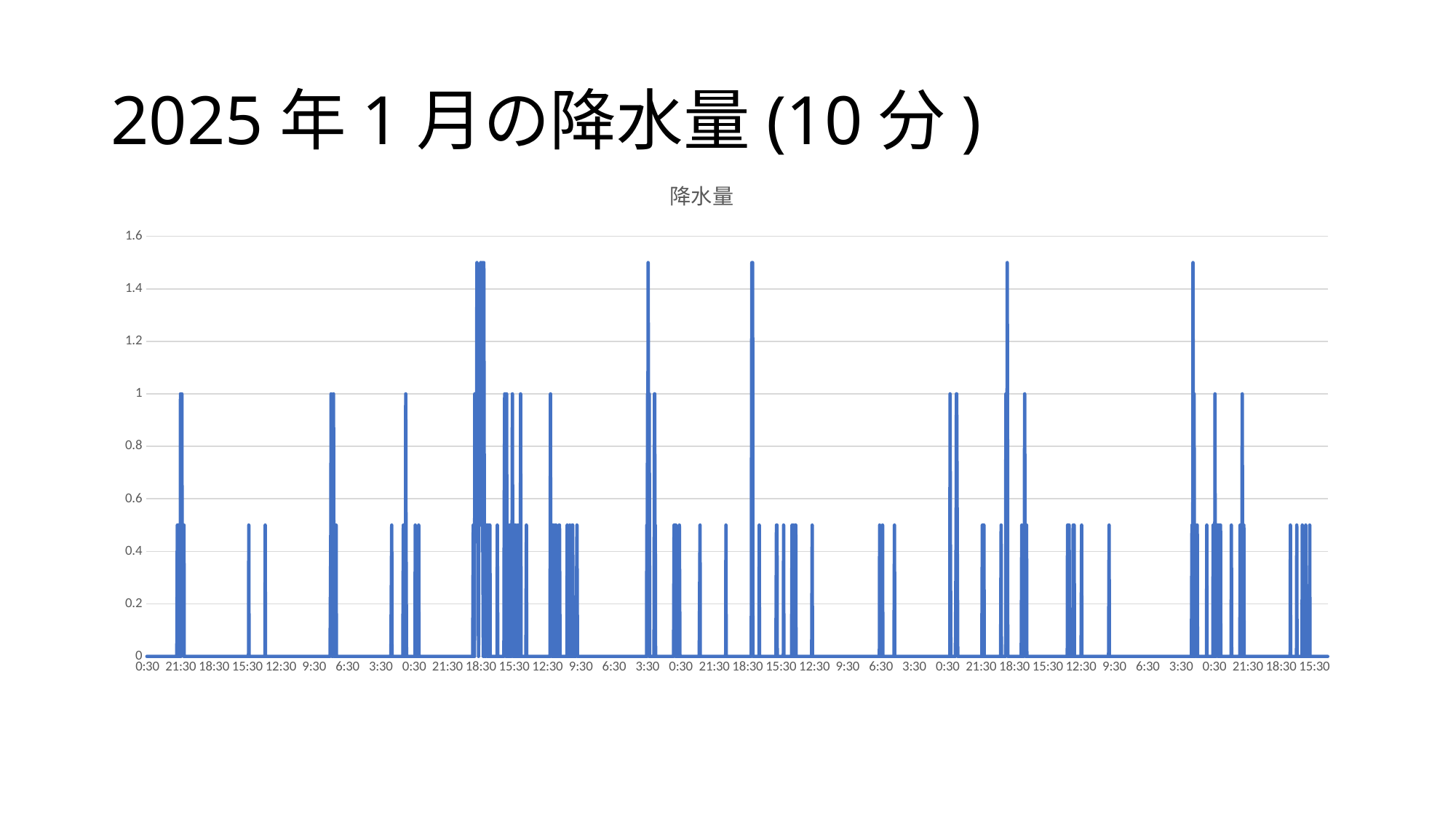
What is the title of the chart? 降水量 Is the tallest spike near the 18:30 label in the left third of the chart greater or less than 1.2? greater What is the highest tick value shown on the vertical axis of the chart? 1.6 Is the highest value plotted on the chart greater or less than 1.6? less Are the many short spikes across the chart greater or less than 0.6? less What kind of chart is shown on the slide? line chart